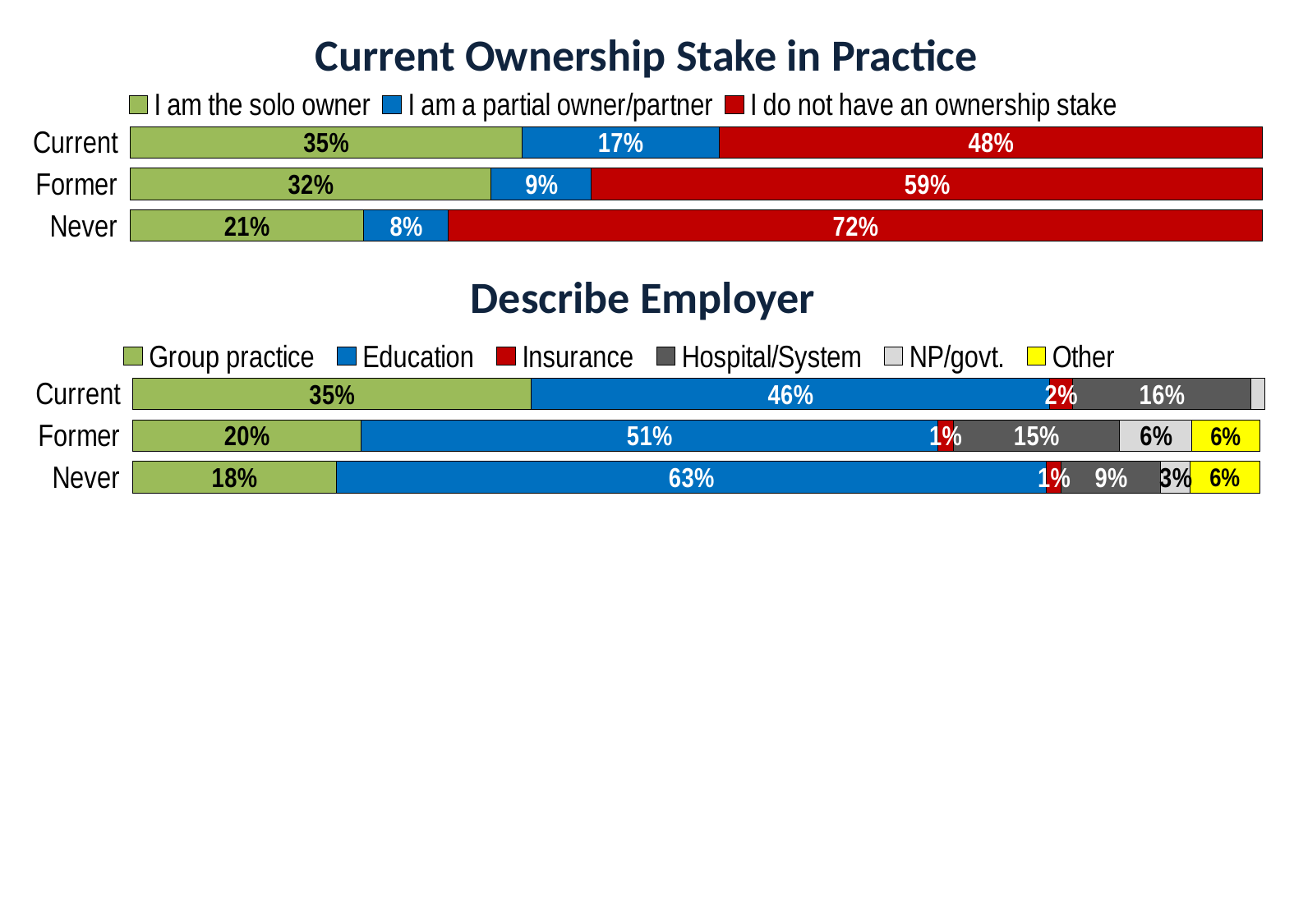
In the 'Current Ownership Stake in Practice' chart, what is the difference between the Never and Current groups' shares with no ownership stake? 24% In the 'Describe Employer' chart, which group has the lowest share in Group practice? Never In the 'Current Ownership Stake in Practice' chart, what percentage of the Never group do not have an ownership stake? 72% In the 'Describe Employer' chart, how many groups (categories) are shown? 3 In the 'Current Ownership Stake in Practice' chart, what percentage of the Current group are partial owners/partners? 17% In the 'Current Ownership Stake in Practice' chart, how many series does the legend list? 3 In the 'Describe Employer' chart, what percentage of the Former group work for a Hospital/System? 15% In the 'Describe Employer' chart, is the Education share larger for the Former group or the Current group? Former What kind of chart is 'Describe Employer'? Stacked bar chart In the 'Describe Employer' chart, how many series does the legend list? 6 In the 'Current Ownership Stake in Practice' chart, which group has the highest share of solo owners? Current In the 'Describe Employer' chart, what percentage of the Never group work in Education? 63%